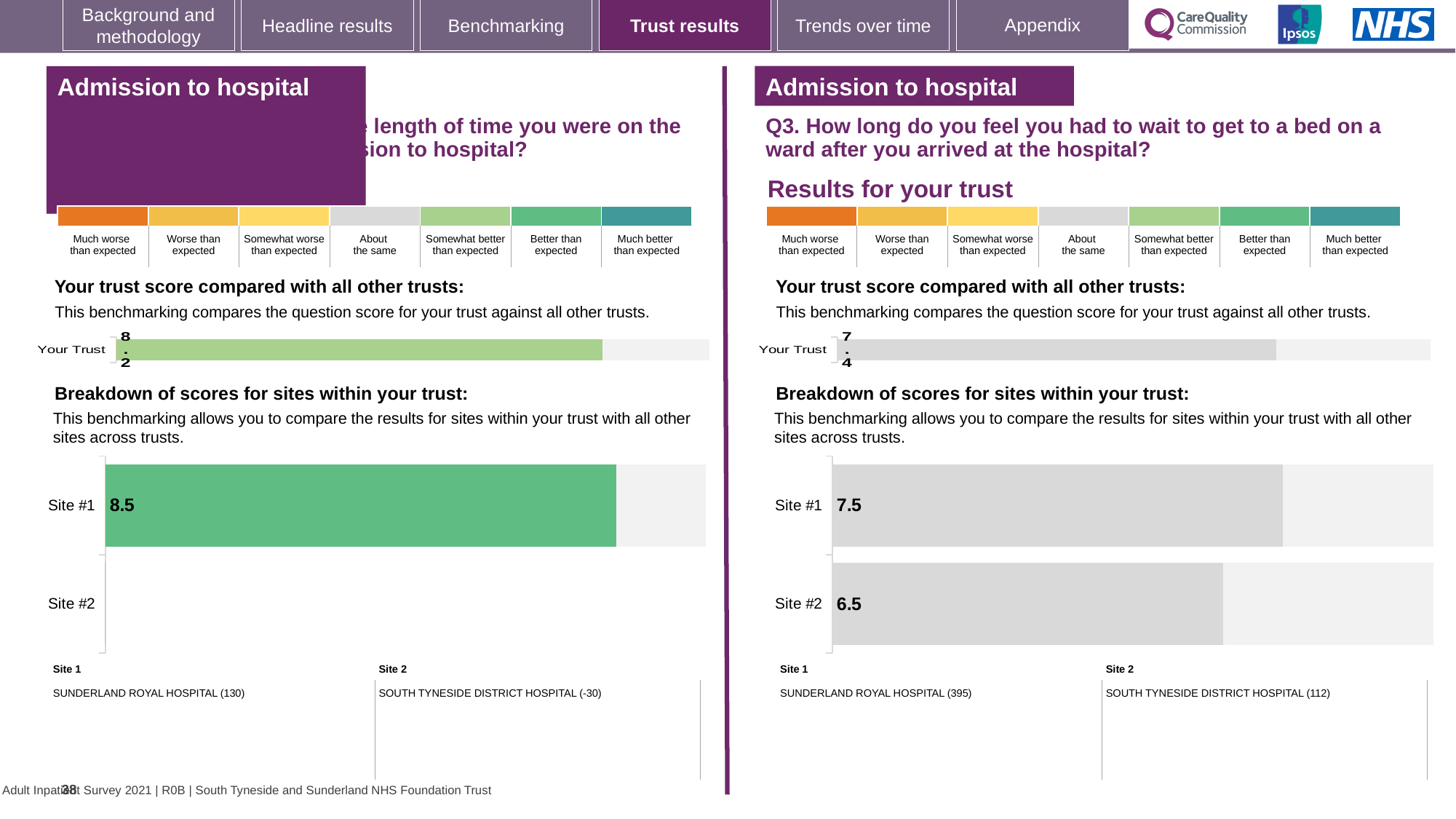
On the right-hand chart for Q3, what is the score for Site #1? 7.5 On the left-hand chart, which benchmark category does the green colour of the Site #1 bar correspond to? Better than expected On the left-hand chart, how many sites are listed in the breakdown of scores? 2 On the right-hand chart for Q3 (wait to get to a bed on a ward), what is the score for Your Trust? 7.4 On the right-hand chart for Q3, what is the difference between the Site #1 and Site #2 scores? 1.0 On the left-hand chart (the first question on the slide), what is the score for Your Trust? 8.2 On the right-hand chart for Q3, which site has the higher score, Site #1 or Site #2? Site #1 What kind of chart is used to show the breakdown of scores for sites within the trust on the right-hand side? Bar chart On the left-hand chart, what is the score for Site #1? 8.5 On the right-hand chart for Q3, which site has the lowest score? Site #2 On the right-hand chart for Q3, what is the score for Site #2? 6.5 On the right-hand chart for Q3, which benchmark category does the grey colour of the Your Trust bar correspond to? About the same